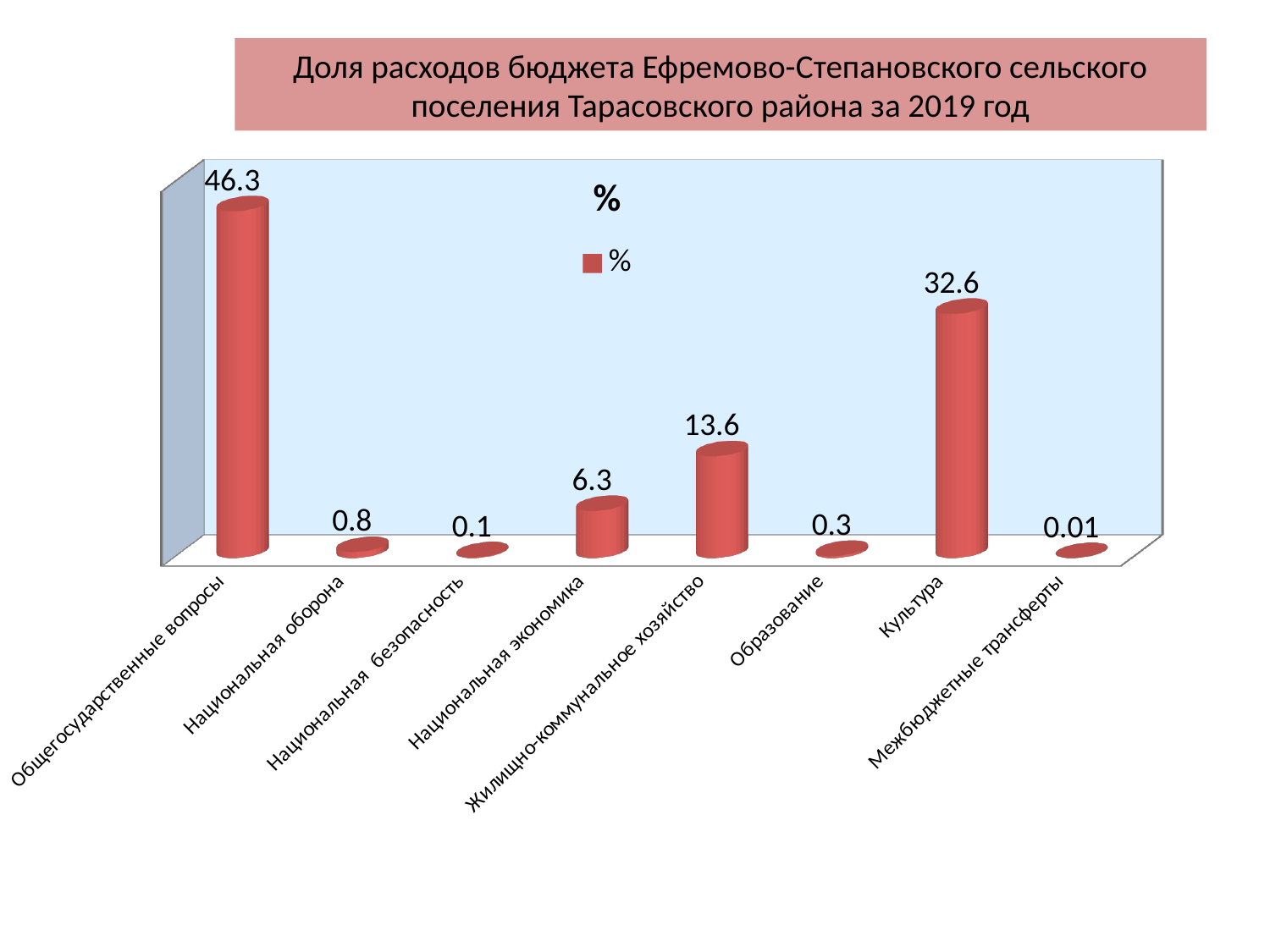
What is the legend entry shown on the chart? % What kind of chart is shown on the slide? Bar chart Which category has the highest value? Общегосударственные вопросы How many categories are shown on the chart? 8 Which category has the lowest value? Межбюджетные трансферты How many series does the legend list? 1 What is the value for Культура? 32.6 What is the difference between the values for Общегосударственные вопросы and Культура? 13.7 What is the value for Межбюджетные трансферты? 0.01 What is the value for Жилищно-коммунальное хозяйство? 13.6 Which is larger, the value for Национальная экономика or the value for Жилищно-коммунальное хозяйство? Жилищно-коммунальное хозяйство What is the value for Общегосударственные вопросы? 46.3